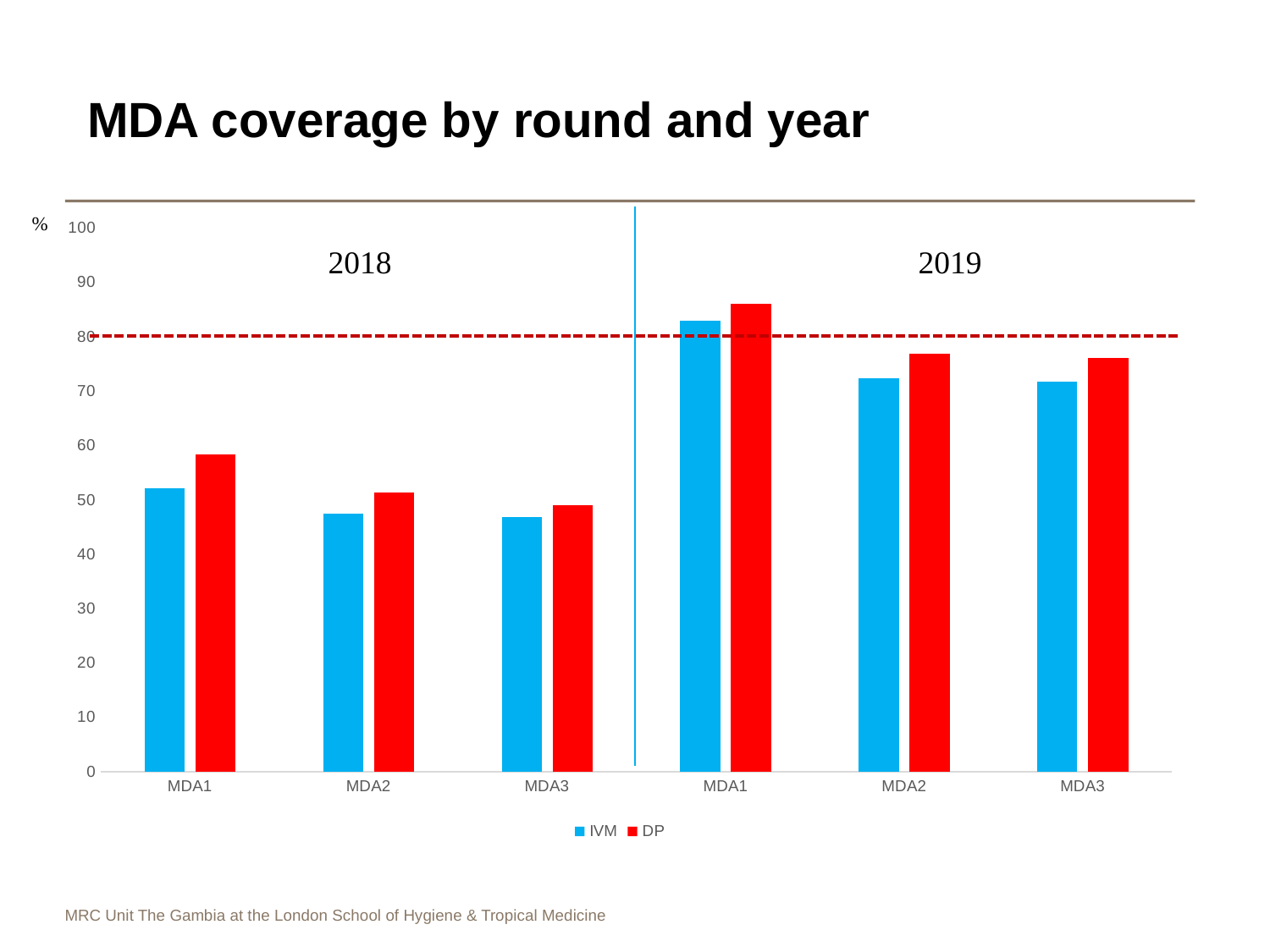
How many MDA round categories are shown along the x axis? 6 What kind of chart is shown on the slide? bar chart Is the IVM value for MDA1 in 2019 greater or less than 80? greater Is the DP value for MDA2 in 2019 greater or less than 70? greater Do the IVM values rise or fall from MDA1 to MDA3 in 2018? fall How many series does the legend list? 2 Is the IVM value for MDA2 in 2018 greater or less than 50? less Which category has the lowest DP bar? MDA3 in 2018 Which is larger, the DP value for MDA1 in 2018 or the DP value for MDA1 in 2019? MDA1 in 2019 Which category has the highest DP bar? MDA1 in 2019 At what value on the y axis is the horizontal red dashed line drawn? 80